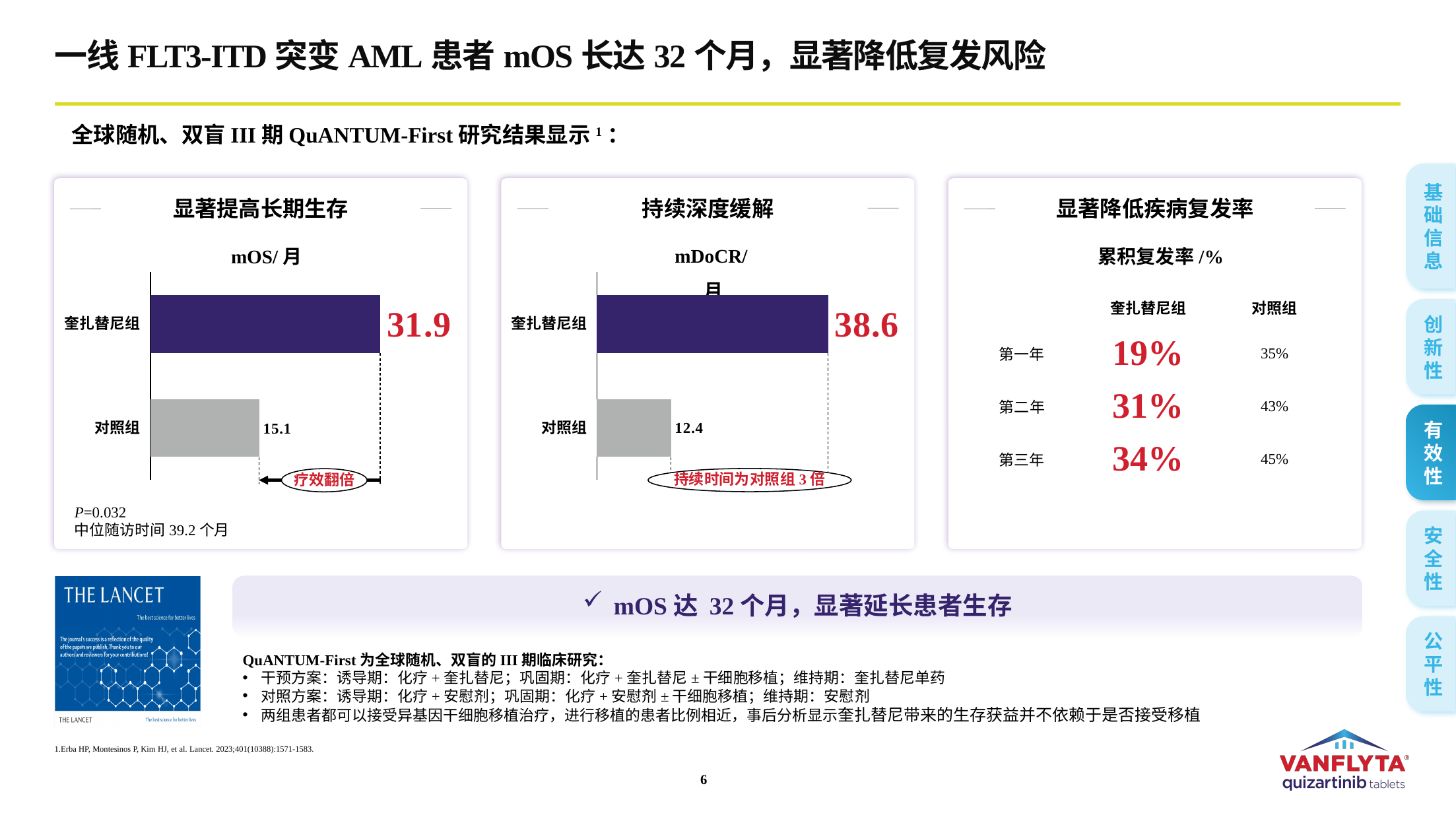
In the mOS/月 chart (left), what is the value for 奎扎替尼组? 31.9 In the mOS/月 chart (left), which group has the lowest value? 对照组 In the mDoCR/月 chart (middle), which group has the highest value? 奎扎替尼组 In the mDoCR/月 chart (middle), what is the value for 对照组? 12.4 In the mDoCR/月 chart (middle), what is the value for 奎扎替尼组? 38.6 In the mDoCR/月 chart (middle), what is the difference between the 奎扎替尼组 and 对照组 values? 26.2 In the mOS/月 chart (left), what is the difference between the 奎扎替尼组 and 对照组 values? 16.8 What type of chart is the mDoCR/月 chart (middle)? Bar chart What P value is printed below the mOS/月 chart (left)? P=0.032 In the mOS/月 chart (left), what is the value for 对照组? 15.1 In the mOS/月 chart (left), which group has the larger value, 奎扎替尼组 or 对照组? 奎扎替尼组 How many groups (bars) are shown in the mOS/月 chart (left)? 2